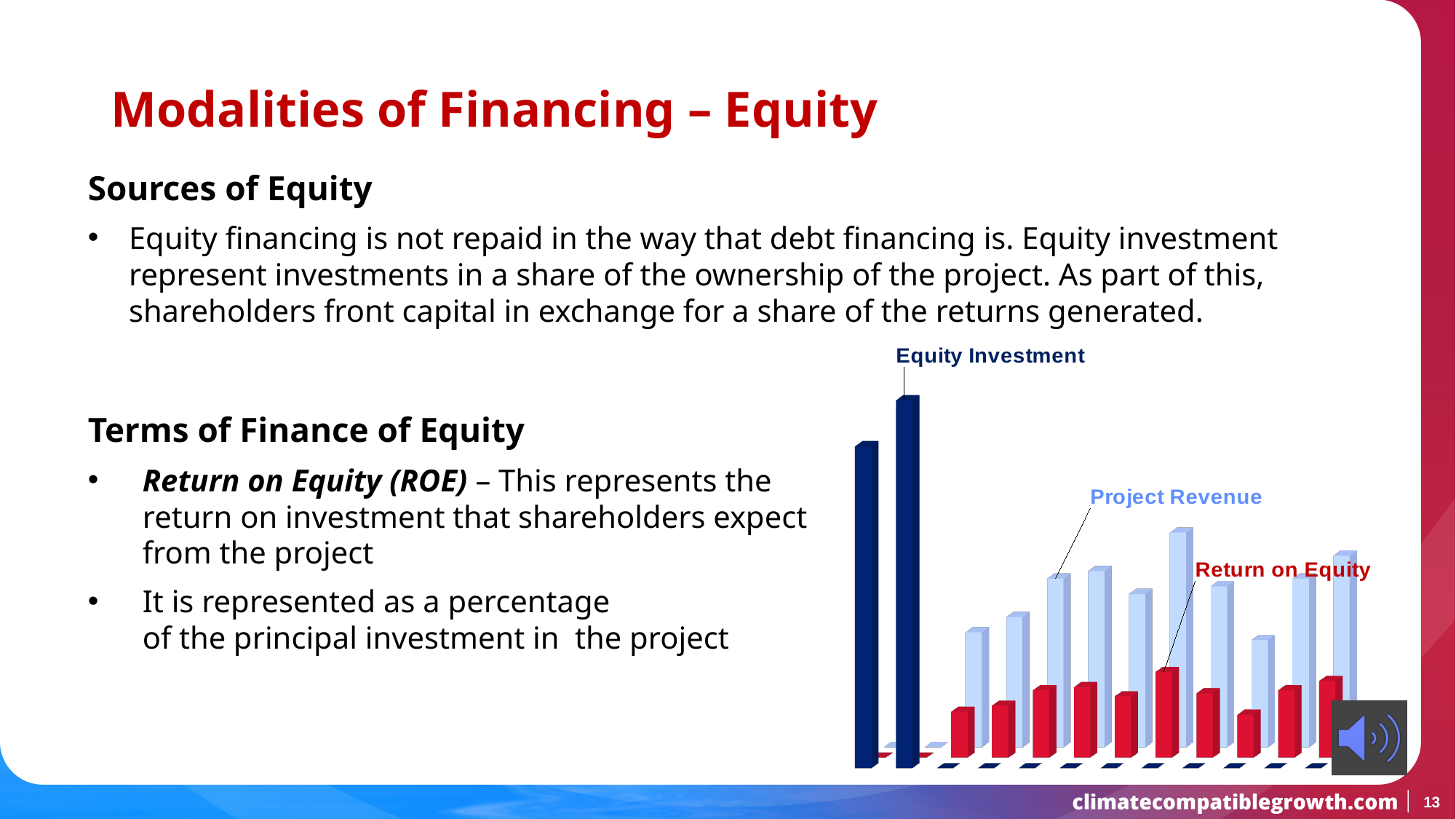
What kind of chart is shown on the slide? bar chart Which series has the tallest bars on the chart? Equity Investment How many Equity Investment bars are shown on the chart? 2 Are the Project Revenue bars taller or shorter than the Return on Equity bars? taller Which series has the shortest bars on the chart? Return on Equity What colour are the Equity Investment bars? dark blue How many data series are labelled on the chart? 3 What colour are the Return on Equity bars? red Are the Equity Investment bars taller or shorter than the Project Revenue bars? taller